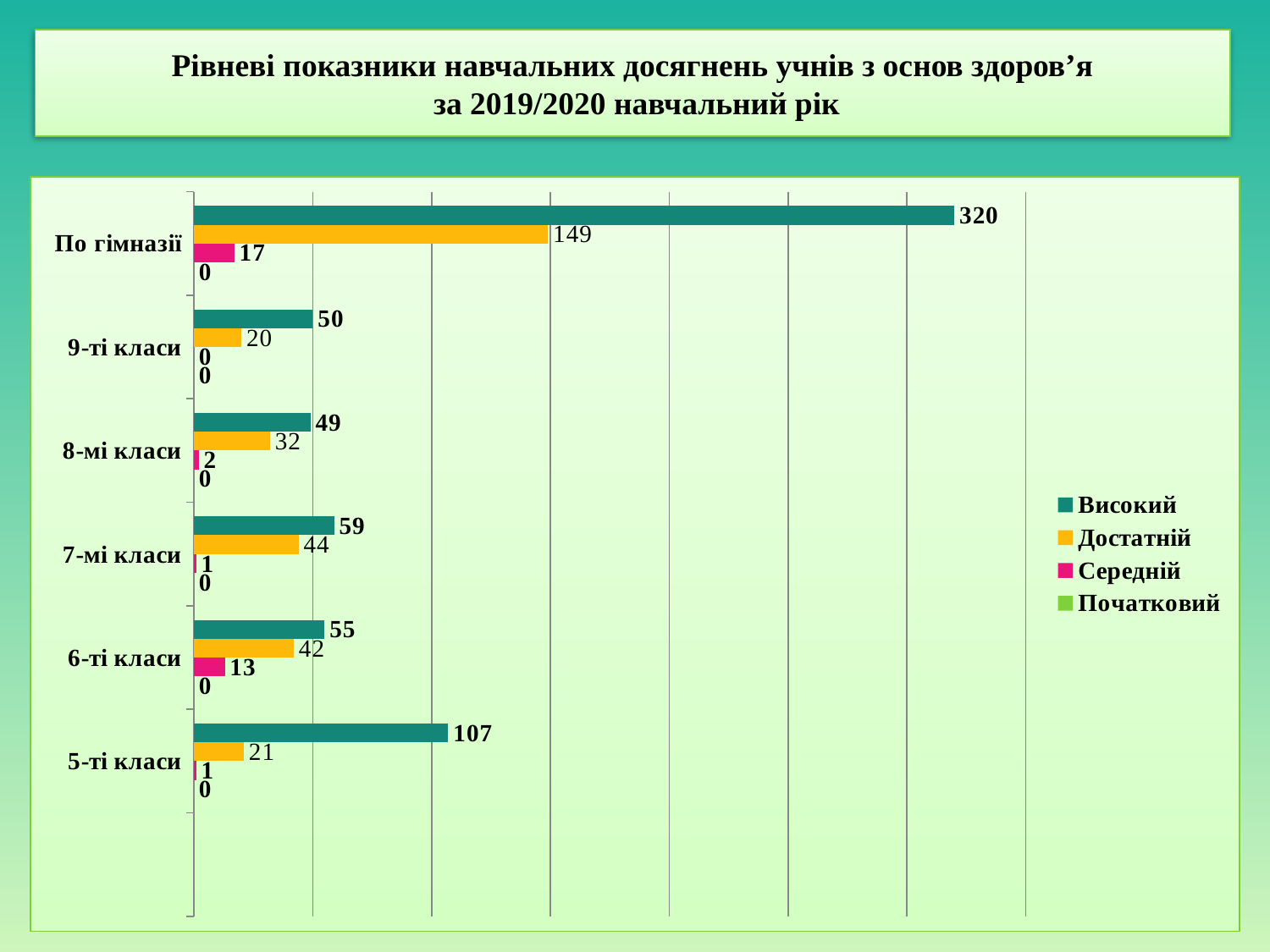
What is the value of Середній for 6-ті класи? 13 What is the value of Високий for 5-ті класи? 107 Among the class groups (excluding По гімназії), which has the lowest Достатній value? 9-ті класи What is the value of Високий for По гімназії? 320 Which series is shown in pink in the legend? Середній How many categories are shown on the vertical axis? 6 What is the value of Достатній for 7-мі класи? 44 What is the difference between the Високий and Достатній values for По гімназії? 171 Which is larger: the Достатній value for 8-мі класи or for 6-ті класи? 6-ті класи How many series does the legend list? 4 What type of chart is shown on the slide? Bar chart Among the class groups (excluding По гімназії), which has the highest Високий value? 5-ті класи